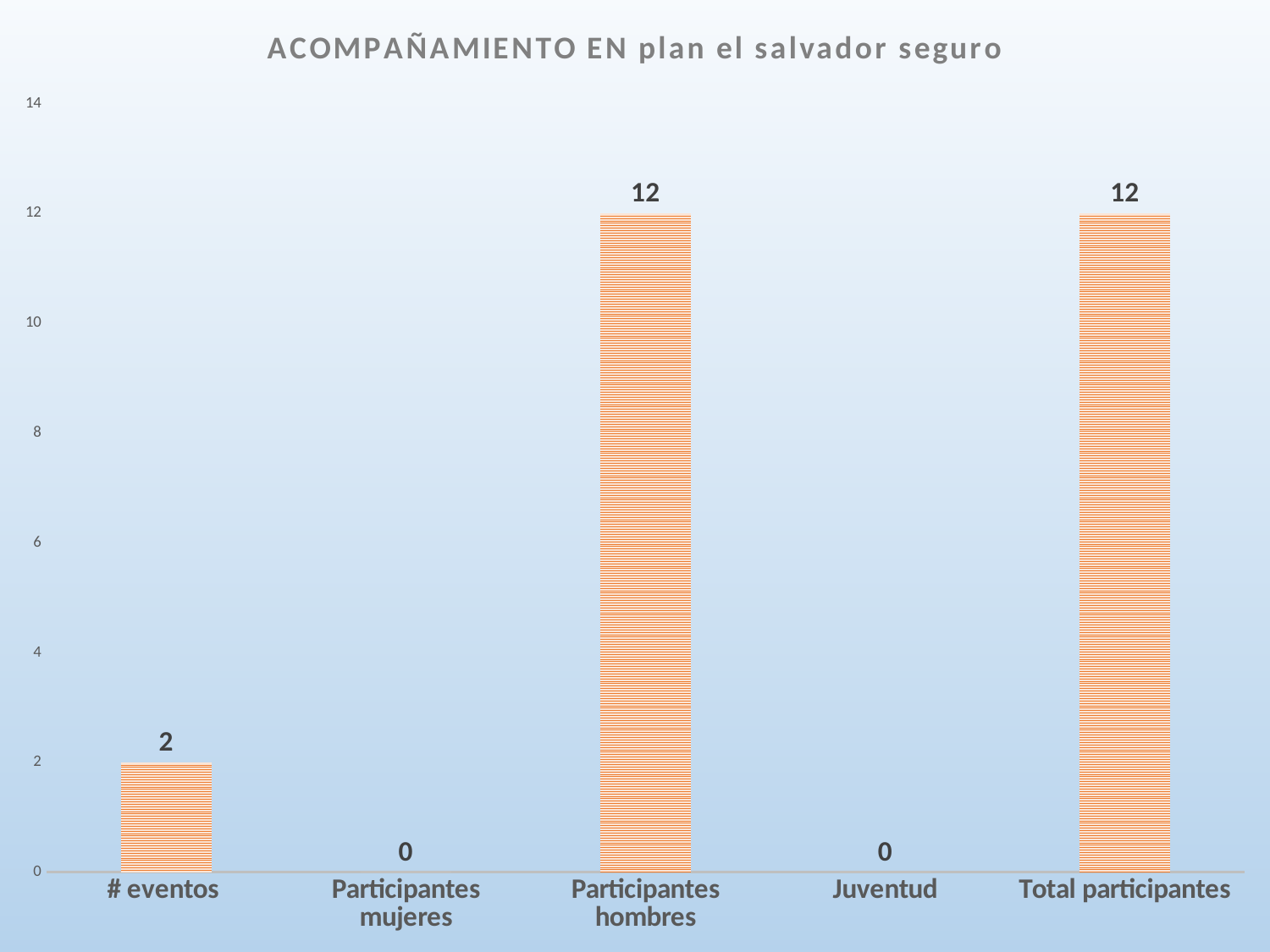
How many categories have a value of 0? 2 What is the title of the chart? ACOMPAÑAMIENTO EN plan el salvador seguro Is the value for Participantes hombres greater or less than 10? greater Which is larger, # eventos or Participantes hombres? Participantes hombres What is the value for Participantes hombres? 12 What is the value for Juventud? 0 What kind of chart is this? bar chart How many categories are shown on the x axis? 5 What is the difference between Participantes hombres and # eventos? 10 What is the value for Participantes mujeres? 0 What is the value for Total participantes? 12 What is the value for # eventos? 2